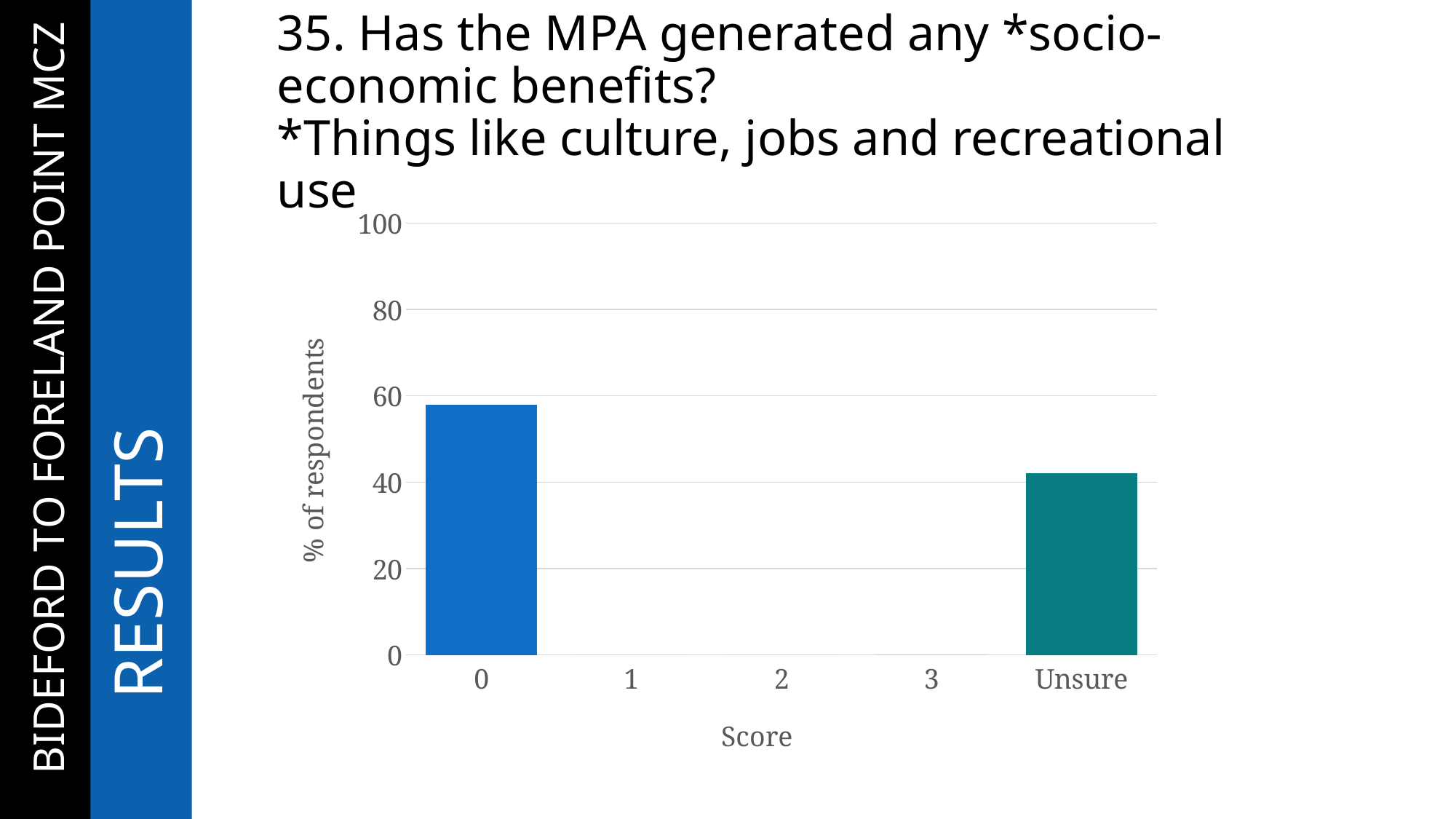
Is the value for Unsure greater or less than 60? less Is the value for score 0 greater or less than 60? less Is the value for score 0 greater or less than 40? greater What kind of chart is shown on the slide? bar chart Which is larger, the value for score 0 or the value for Unsure? 0 Which score category has the highest percentage of respondents? 0 What is the percentage of respondents for score 2? 0 What is the percentage of respondents for score 3? 0 How many categories are shown on the x axis of the chart? 5 What is the label on the y axis of the chart? % of respondents What is the label on the x axis of the chart? Score